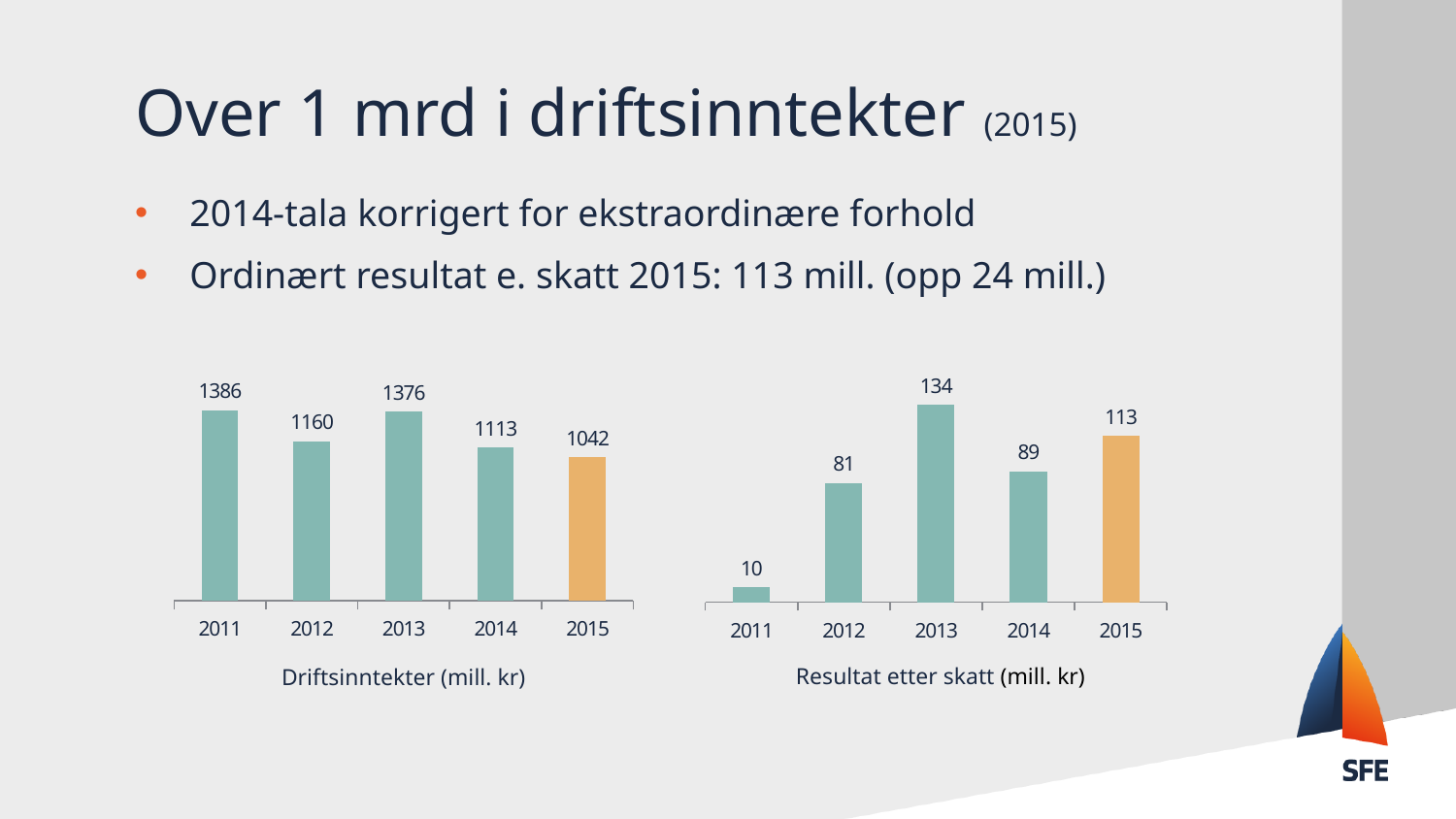
In the Resultat etter skatt (mill. kr) chart, what is the value for 2012? 81 In the Driftsinntekter (mill. kr) chart, which year's bar is coloured orange instead of teal? 2015 In the Driftsinntekter (mill. kr) chart, which year has the lowest value? 2015 In the Resultat etter skatt (mill. kr) chart, what is the difference between the 2015 and 2014 values? 24 In the Driftsinntekter (mill. kr) chart, which year has the highest value? 2011 In the Resultat etter skatt (mill. kr) chart, which is larger, the value for 2013 or the value for 2015? 2013 In the Resultat etter skatt (mill. kr) chart, which year has the highest value? 2013 In the Resultat etter skatt (mill. kr) chart, which year has the lowest value? 2011 What kind of chart is the Driftsinntekter (mill. kr) chart? Bar chart In the Driftsinntekter (mill. kr) chart, what is the value for 2013? 1376 In the Driftsinntekter (mill. kr) chart, how many years are shown? 5 In the Driftsinntekter (mill. kr) chart, what is the difference between the 2014 and 2015 values? 71